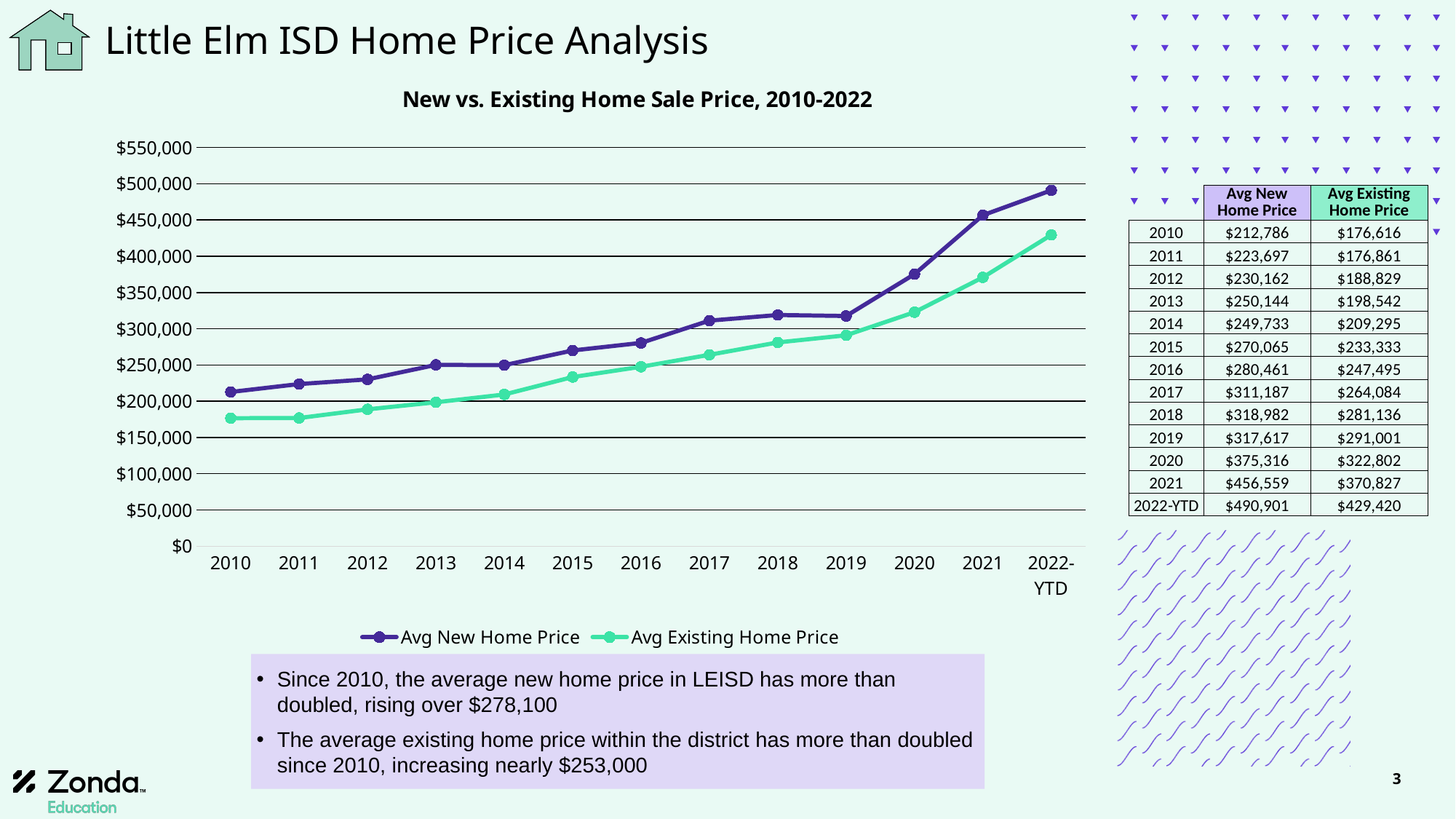
What is the Avg New Home Price for 2019? $317,617 Overall, do the Avg Existing Home Price values rise or fall from 2010 to 2022-YTD? rise What is the Avg Existing Home Price for 2015? $233,333 What is the Avg New Home Price for 2022-YTD? $490,901 How many series does the chart legend list? 2 What is the difference between the Avg New Home Price and the Avg Existing Home Price in 2022-YTD? $61,481 In which year is the Avg New Home Price highest? 2022-YTD How many years (points) are plotted along the x axis? 13 Is the Avg Existing Home Price for 2020 greater or less than $300,000? greater In 2017, which is larger: the Avg New Home Price or the Avg Existing Home Price? Avg New Home Price What kind of chart is shown on the slide? line chart In which year is the Avg New Home Price lowest? 2010